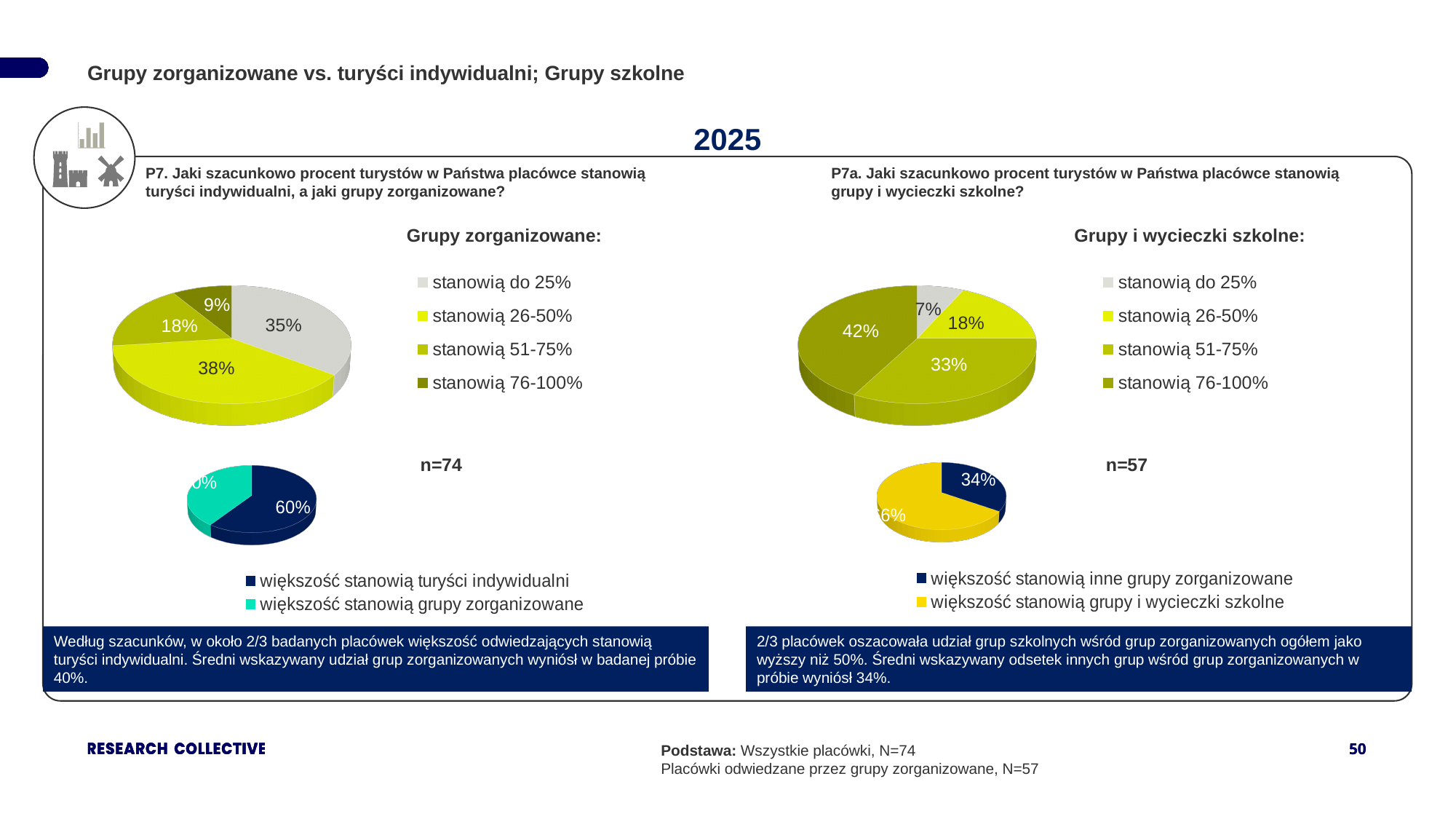
In the 'Grupy i wycieczki szkolne:' pie chart, what share is labelled for 'stanowią do 25%'? 7% How many categories does the legend of the 'Grupy zorganizowane:' pie chart list? 4 In the 'Grupy i wycieczki szkolne:' pie chart, what share is labelled for 'stanowią 76-100%'? 42% What type of chart is used for 'Grupy i wycieczki szkolne:'? Pie chart In the 'Grupy zorganizowane:' pie chart, what share is labelled for 'stanowią do 25%'? 35% In the bottom-left pie chart, what share is labelled for 'większość stanowią turyści indywidualni'? 60% In the 'Grupy i wycieczki szkolne:' pie chart, which category has the largest slice? stanowią 76-100% In the bottom-right pie chart, what share is labelled for 'większość stanowią inne grupy zorganizowane'? 34% In the 'Grupy zorganizowane:' pie chart, what share is labelled for 'stanowią 26-50%'? 38% In the 'Grupy zorganizowane:' pie chart, which category has the smallest slice? stanowią 76-100% In the 'Grupy i wycieczki szkolne:' pie chart, which is larger: 'stanowią 51-75%' or 'stanowią 26-50%'? stanowią 51-75% In the 'Grupy zorganizowane:' pie chart, what is the difference between the 'stanowią 26-50%' and 'stanowią 51-75%' slices? 20 percentage points